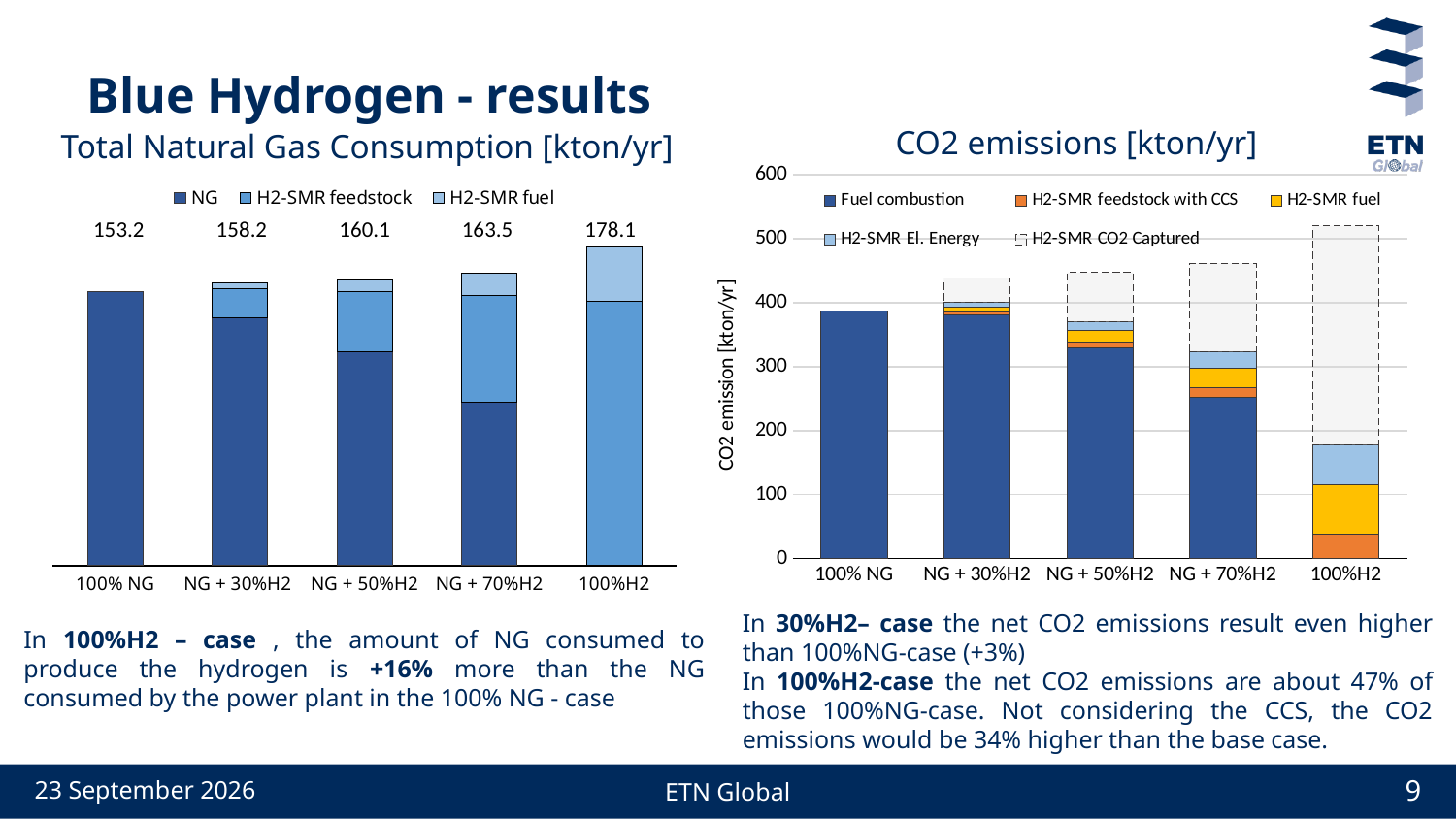
On the Total Natural Gas Consumption chart, which category has the highest total? 100%H2 On the Total Natural Gas Consumption chart, what is the total value for the NG + 50%H2 category? 160.1 On the Total Natural Gas Consumption chart, which category has the lowest total? 100% NG On the Total Natural Gas Consumption chart, do the totals rise or fall from 100% NG to 100%H2? rise How many categories are shown on the x axis of the CO2 emissions chart? 5 What kind of chart is the CO2 emissions chart? stacked bar chart On the CO2 emissions chart, is the Fuel combustion value for 100% NG greater or less than 300? greater On the Total Natural Gas Consumption chart, what is the total value for the 100%H2 category? 178.1 On the Total Natural Gas Consumption chart, which has a larger total, NG + 30%H2 or NG + 70%H2? NG + 70%H2 How many series does the legend of the CO2 emissions chart list? 5 How many series does the legend of the Total Natural Gas Consumption chart list? 3 On the Total Natural Gas Consumption chart, what is the difference between the totals for 100%H2 and 100% NG? 24.9